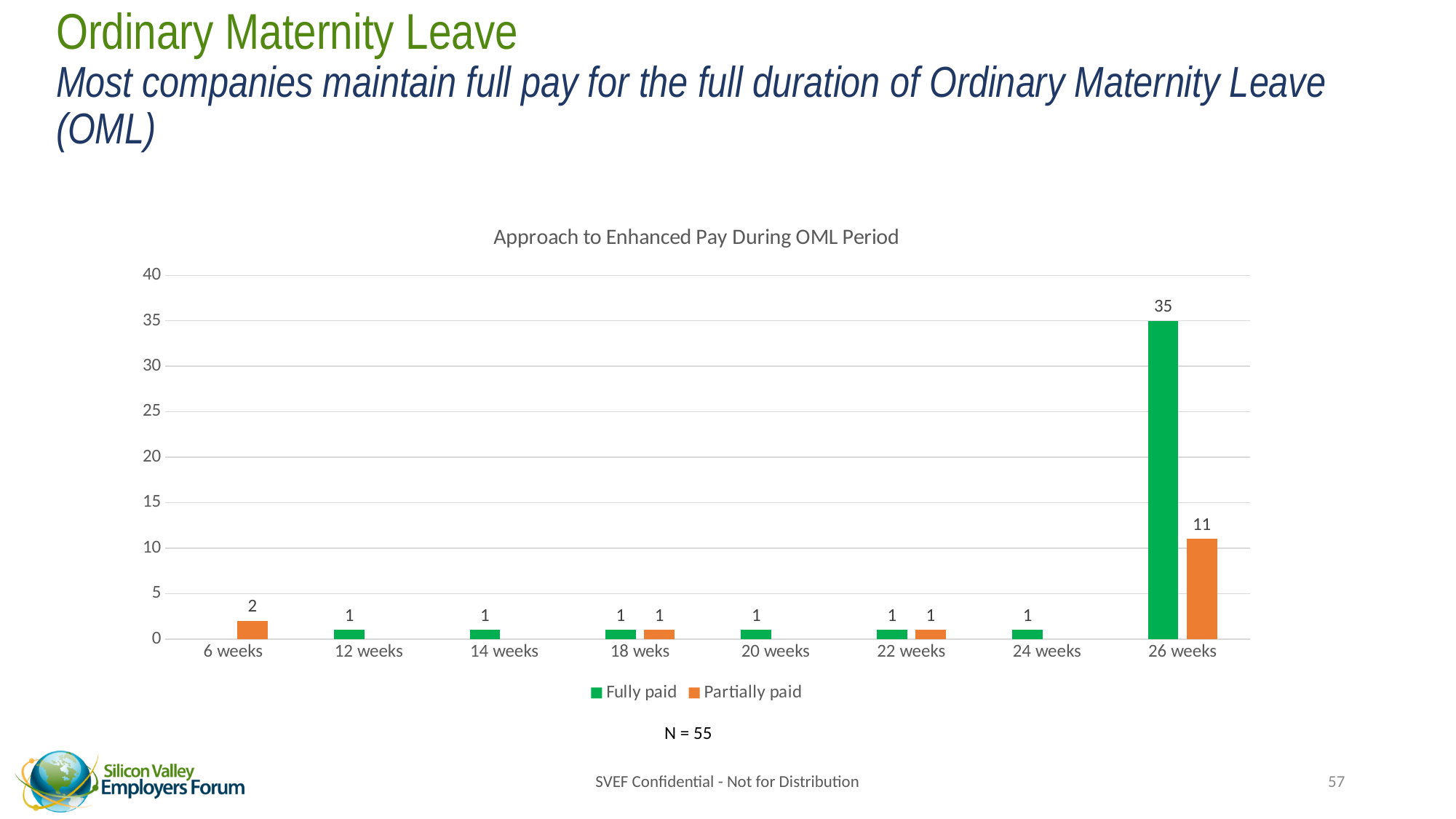
What kind of chart is shown? Bar chart Which category has the highest Fully paid value? 26 weeks What is the Partially paid value for 6 weeks? 2 What is the Fully paid value for 26 weeks? 35 What is the Fully paid value for 18 weks? 1 Which is larger for 26 weeks, Fully paid or Partially paid? Fully paid What is the Partially paid value for 26 weeks? 11 What is the title of the chart? Approach to Enhanced Pay During OML Period How many categories are shown on the x axis? 8 How many series does the legend list? 2 What is the difference between the Fully paid and Partially paid values for 26 weeks? 24 Is the Fully paid value for 26 weeks greater or less than 30? greater